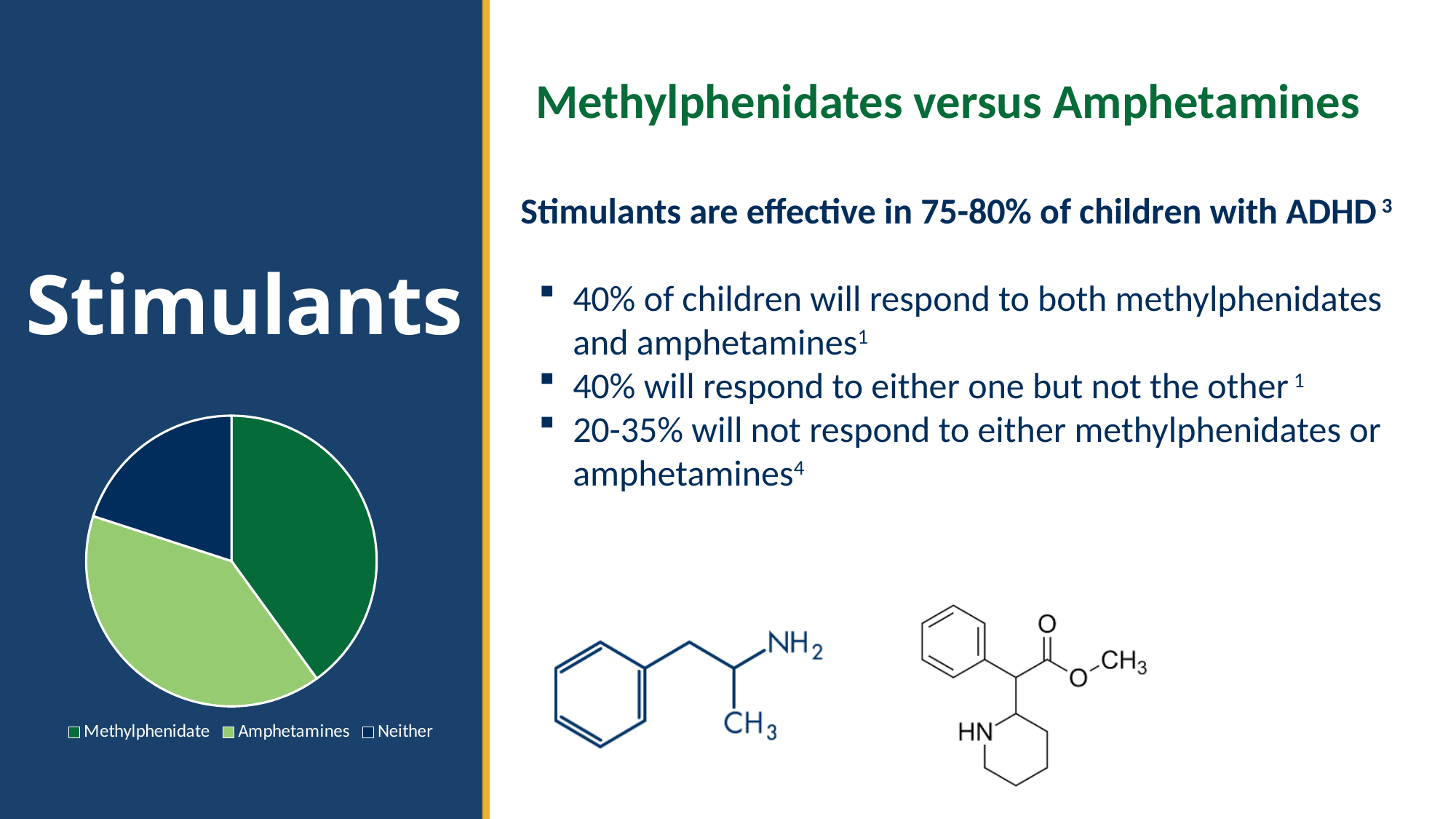
How many entries does the pie chart's legend list? 3 What kind of chart is shown on the slide? pie chart Which category has the smallest slice in the pie chart? Neither What are the three categories listed in the pie chart's legend? Methylphenidate, Amphetamines, Neither Which slice is larger in the pie chart, Amphetamines or Neither? Amphetamines How many slices does the pie chart have? 3 Which slice is larger in the pie chart, Methylphenidate or Neither? Methylphenidate Which category is shown in light green in the pie chart? Amphetamines